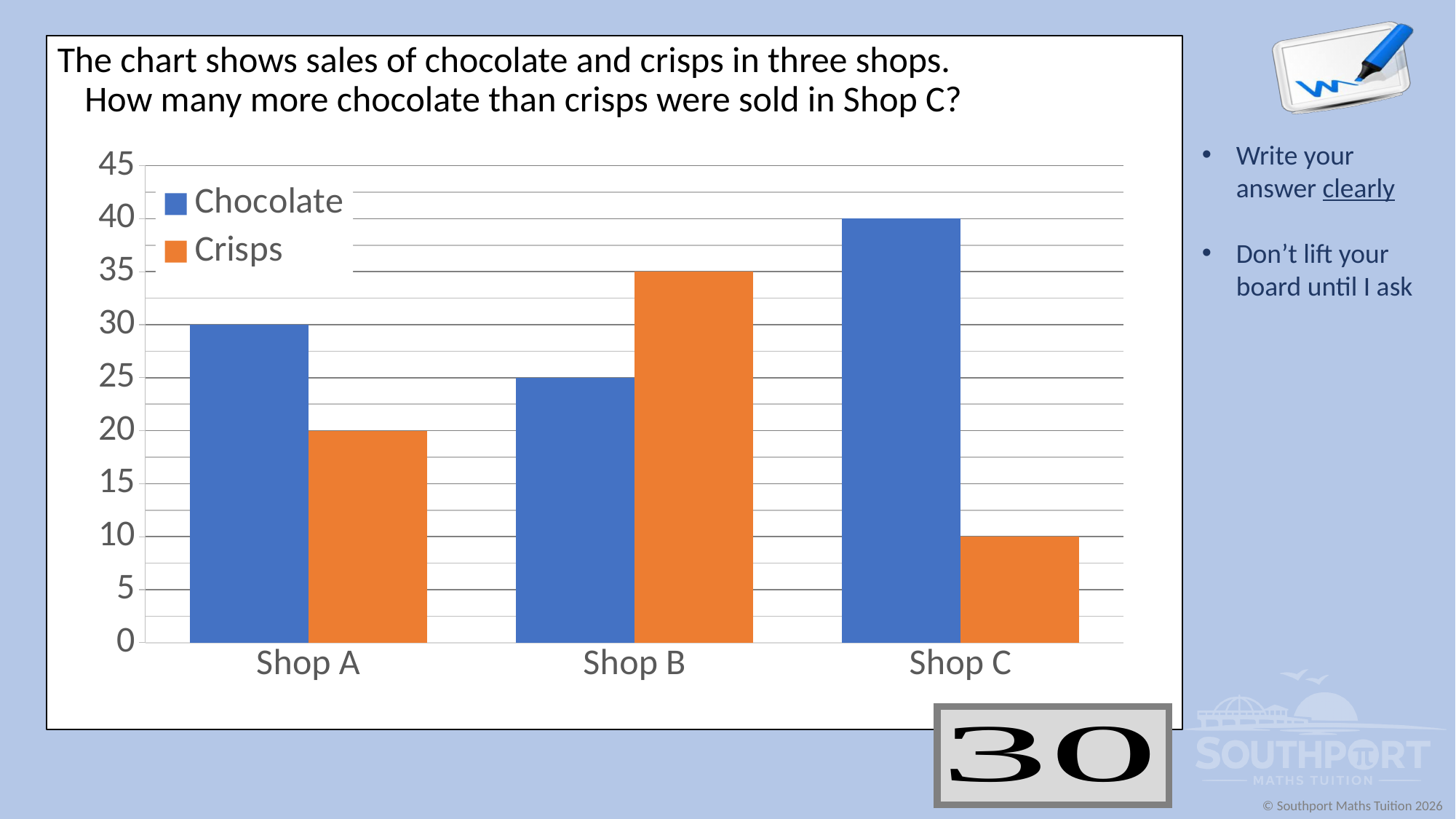
What is the Chocolate value for Shop C? 40 How many more chocolate than crisps were sold in Shop C? 30 What is the Crisps value for Shop B? 35 How many series does the legend list? 2 What is the Crisps value for Shop C? 10 Which shop has the lowest Crisps sales? Shop C Which shop has the highest Chocolate sales? Shop C How many shops are shown on the x axis? 3 What is the Chocolate value for Shop A? 30 In Shop B, which is larger, Chocolate or Crisps sales? Crisps What is the difference between Crisps sales in Shop B and Shop A? 15 What kind of chart is shown on the slide? Bar chart